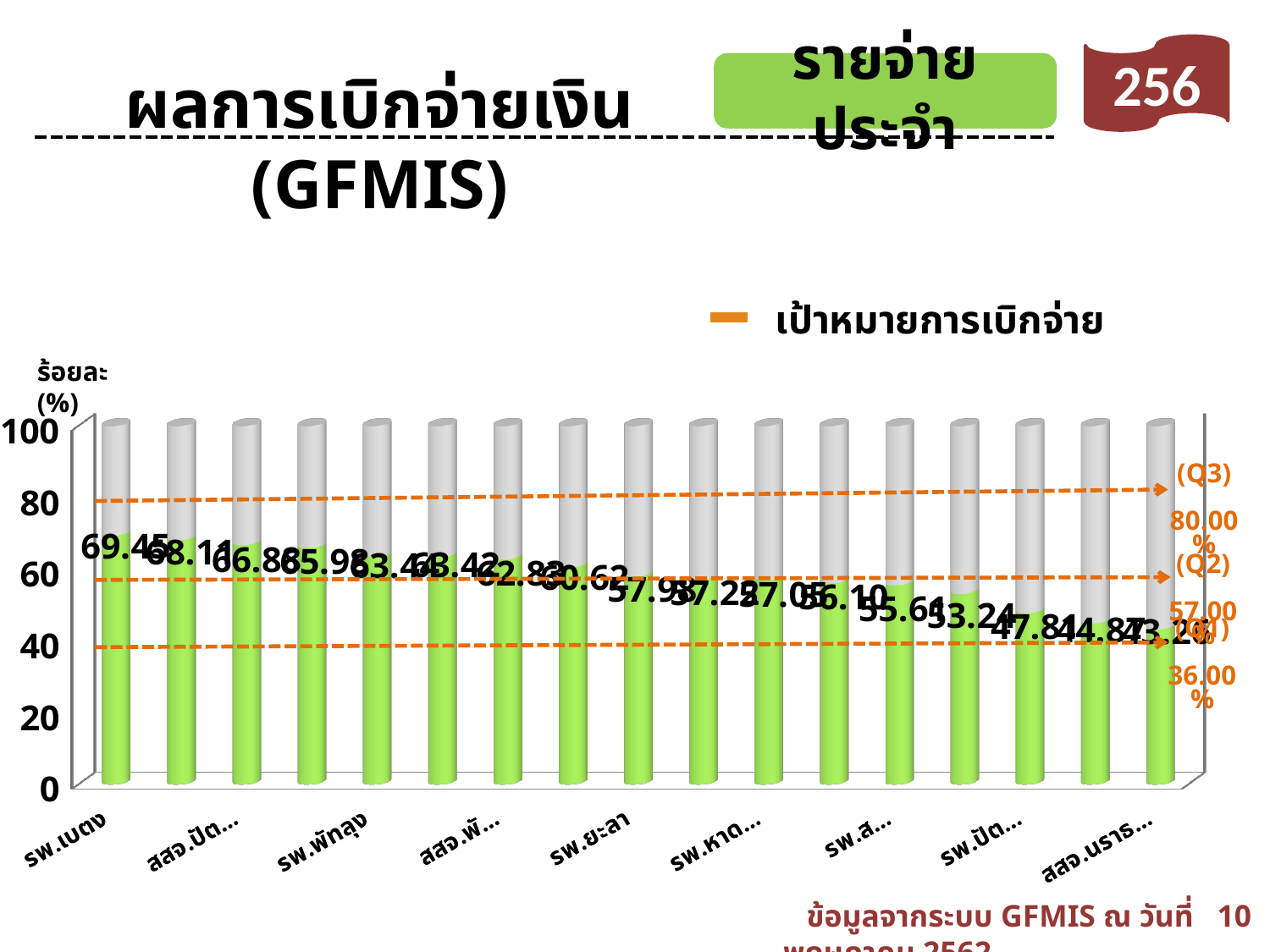
What is the value for รพ.เบตง? 69.45 Which is larger, the value for รพ.เบตง or the value for รพ.ยะลา? รพ.เบตง Do the bar values rise or fall from left to right along the x axis? fall Is the value for สสจ.นราธ... greater or less than 60? less What does the legend entry with the orange dashed line represent? เป้าหมายการเบิกจ่าย Is the value for รพ.เบตง greater or less than 60? greater What is the target percentage shown for Q3 on the chart? 80.00% How many bars are plotted in the chart? 17 Which category has the lowest value? สสจ.นราธ... Which category has the highest value? รพ.เบตง What kind of chart is shown on the slide? bar chart Which is larger, the value for รพ.พัทลุง or the value for สสจ.นราธ...? รพ.พัทลุง